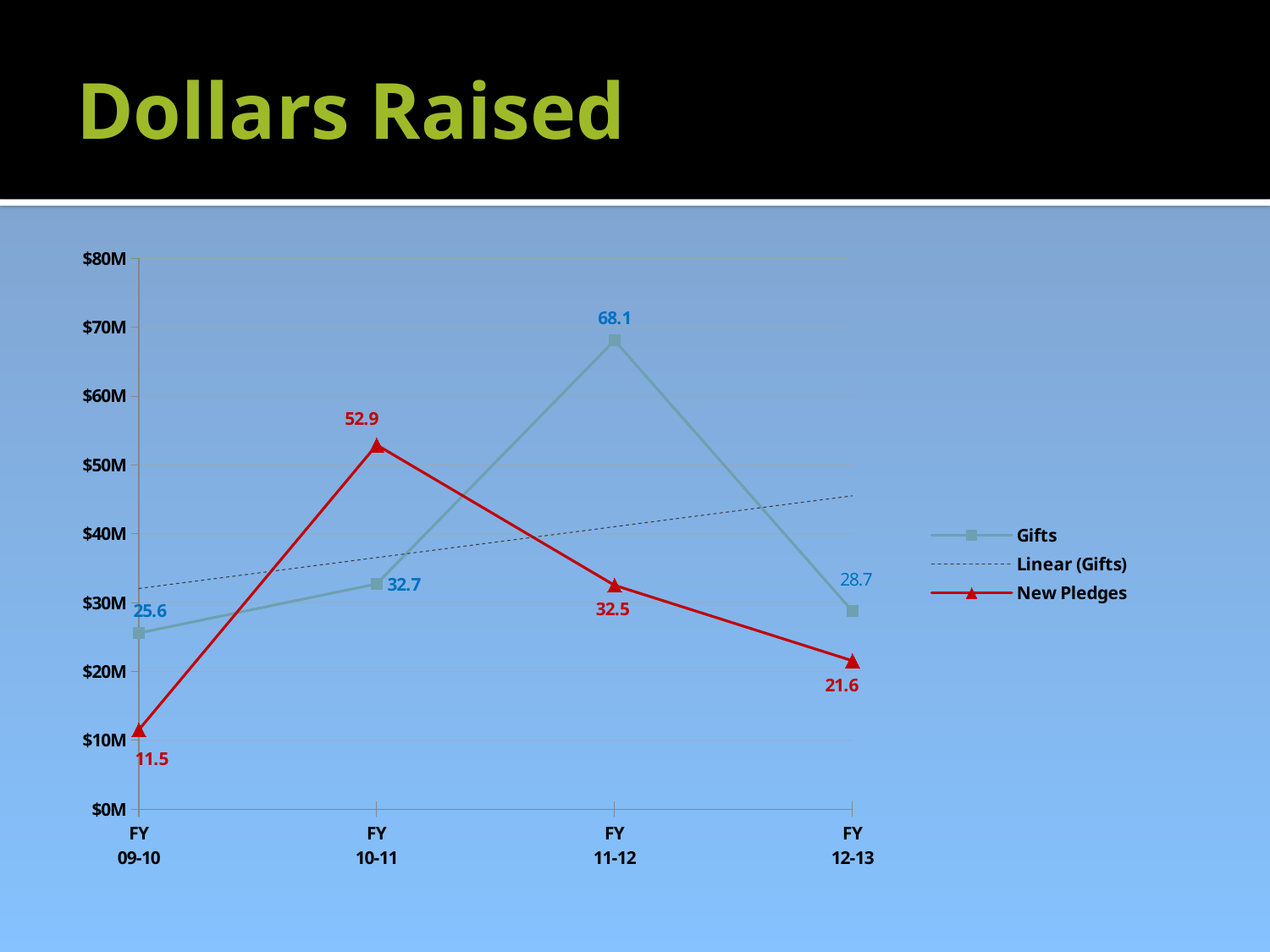
Does the New Pledges series rise or fall from FY 10-11 to FY 12-13? Fall In which fiscal year is the Gifts value highest? FY 11-12 How many fiscal years are shown on the x axis? 4 What is the value for Gifts in FY 11-12? 68.1 What kind of chart is this? Line chart Which is larger in FY 10-11, Gifts or New Pledges? New Pledges How many entries does the legend list? 3 What is the value for New Pledges in FY 12-13? 21.6 What is the value for New Pledges in FY 10-11? 52.9 What is the difference between Gifts and New Pledges in FY 11-12? 35.6 What is the value for Gifts in FY 09-10? 25.6 In which fiscal year is the New Pledges value lowest? FY 09-10